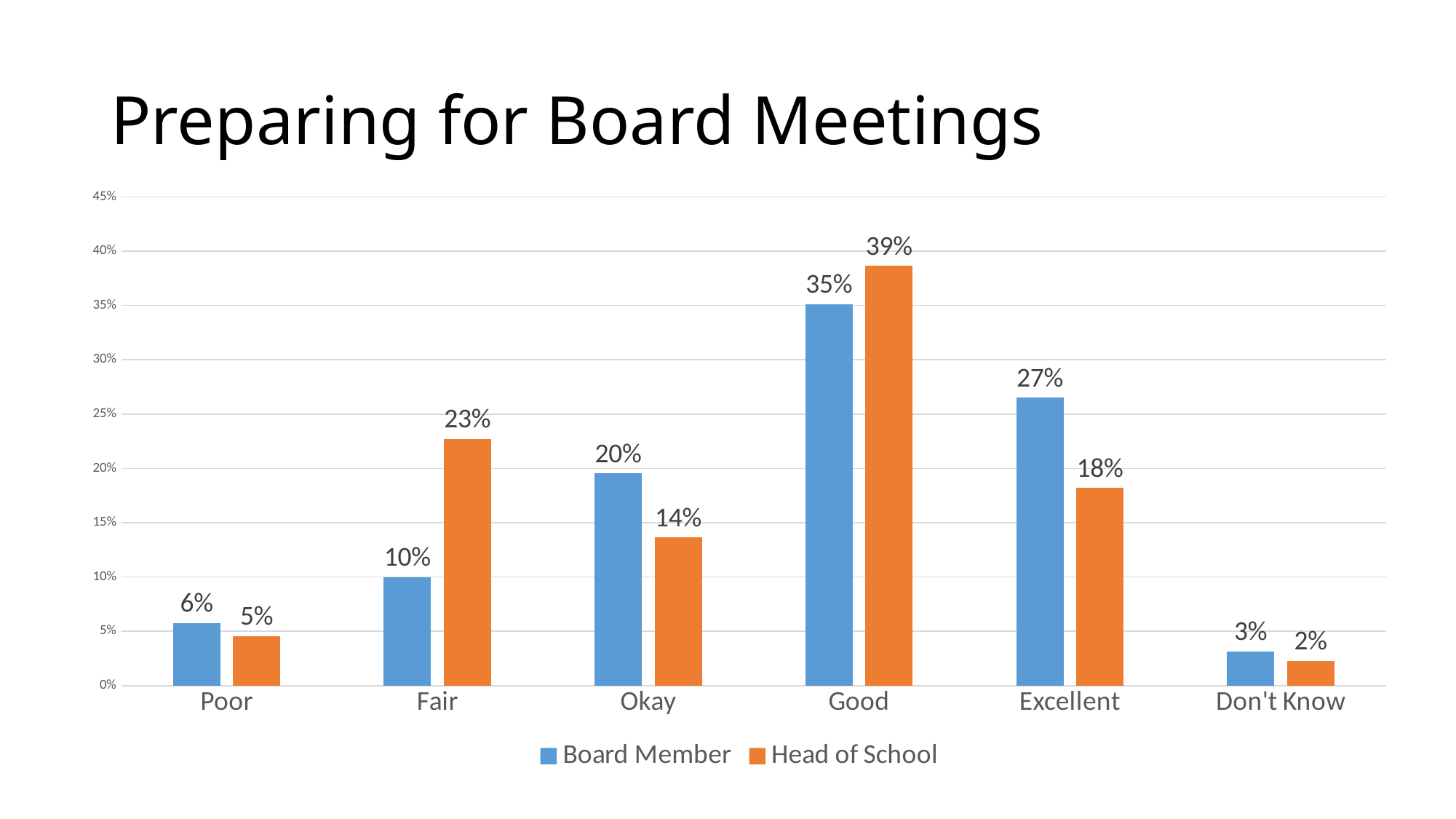
What is the title of the slide? Preparing for Board Meetings For Excellent, which series has the larger value, Board Member or Head of School? Board Member Is the Board Member value for Okay greater or less than 15%? greater How many categories are shown on the x axis? 6 How many series does the legend list? 2 What is the difference between the Head of School and Board Member values for Fair? 13% What is the Board Member value for Good? 35% What is the Head of School value for Excellent? 18% What kind of chart is shown on the slide? Bar chart Which category has the highest Head of School value? Good What is the Head of School value for Fair? 23% Which category has the lowest Board Member value? Don't Know